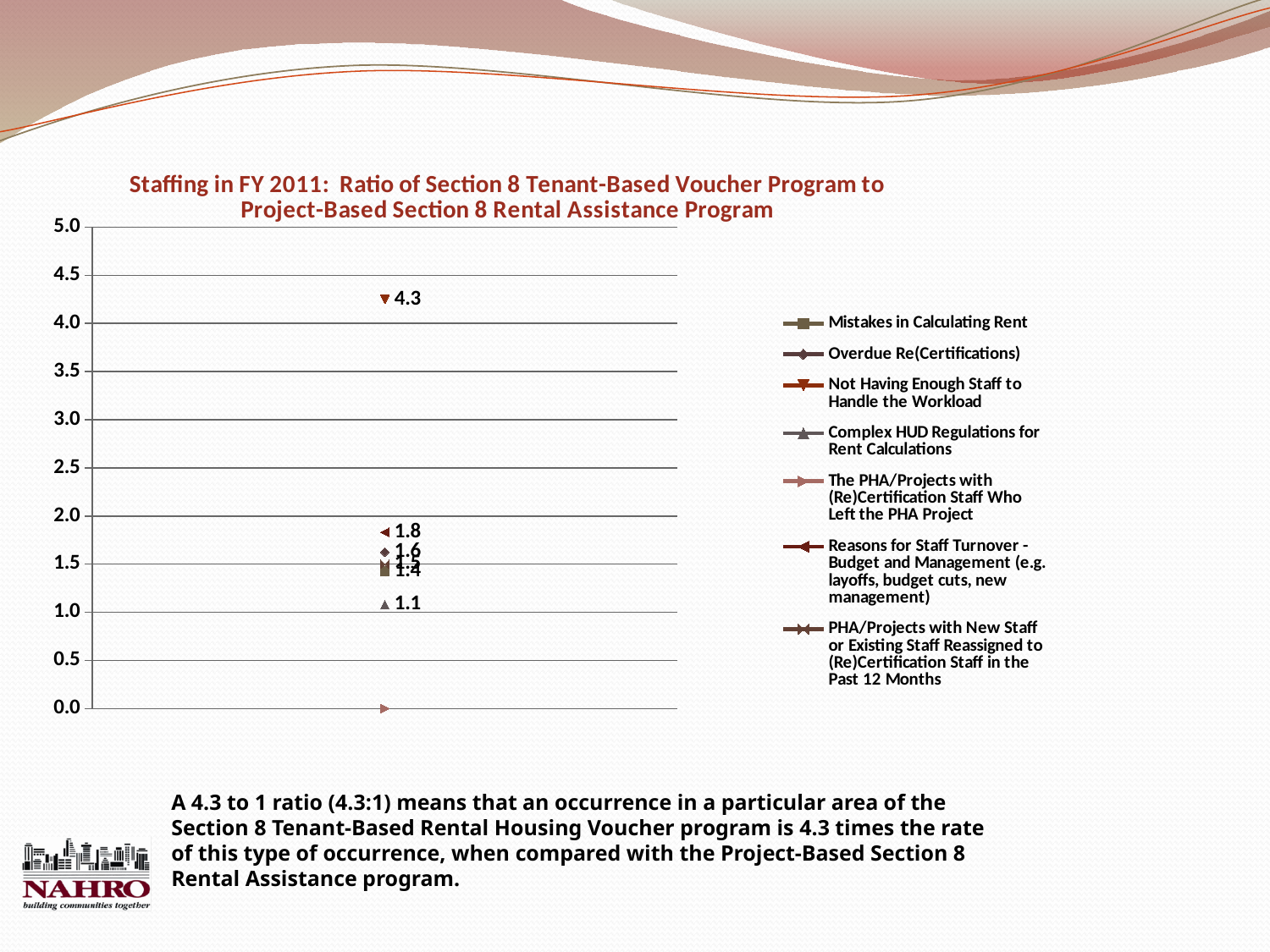
What is the ratio value for Overdue Re(Certifications)? 1.6 How many series does the legend list? 7 Is the value for Not Having Enough Staff to Handle the Workload greater or less than 4.0? greater What is the ratio value for Complex HUD Regulations for Rent Calculations? 1.1 What is the difference between the value for Not Having Enough Staff to Handle the Workload and the value for Complex HUD Regulations for Rent Calculations? 3.2 What is the difference between the value for Not Having Enough Staff to Handle the Workload and the value for Reasons for Staff Turnover - Budget and Management? 2.5 Which series has the lowest value on the chart? The PHA/Projects with (Re)Certification Staff Who Left the PHA Project Which is larger: the value for Overdue Re(Certifications) or the value for Reasons for Staff Turnover - Budget and Management? Reasons for Staff Turnover - Budget and Management What is the ratio value for Not Having Enough Staff to Handle the Workload? 4.3 What is the ratio value for Reasons for Staff Turnover - Budget and Management? 1.8 Which series has the highest ratio value on the chart? Not Having Enough Staff to Handle the Workload What is the title of the chart? Staffing in FY 2011: Ratio of Section 8 Tenant-Based Voucher Program to Project-Based Section 8 Rental Assistance Program